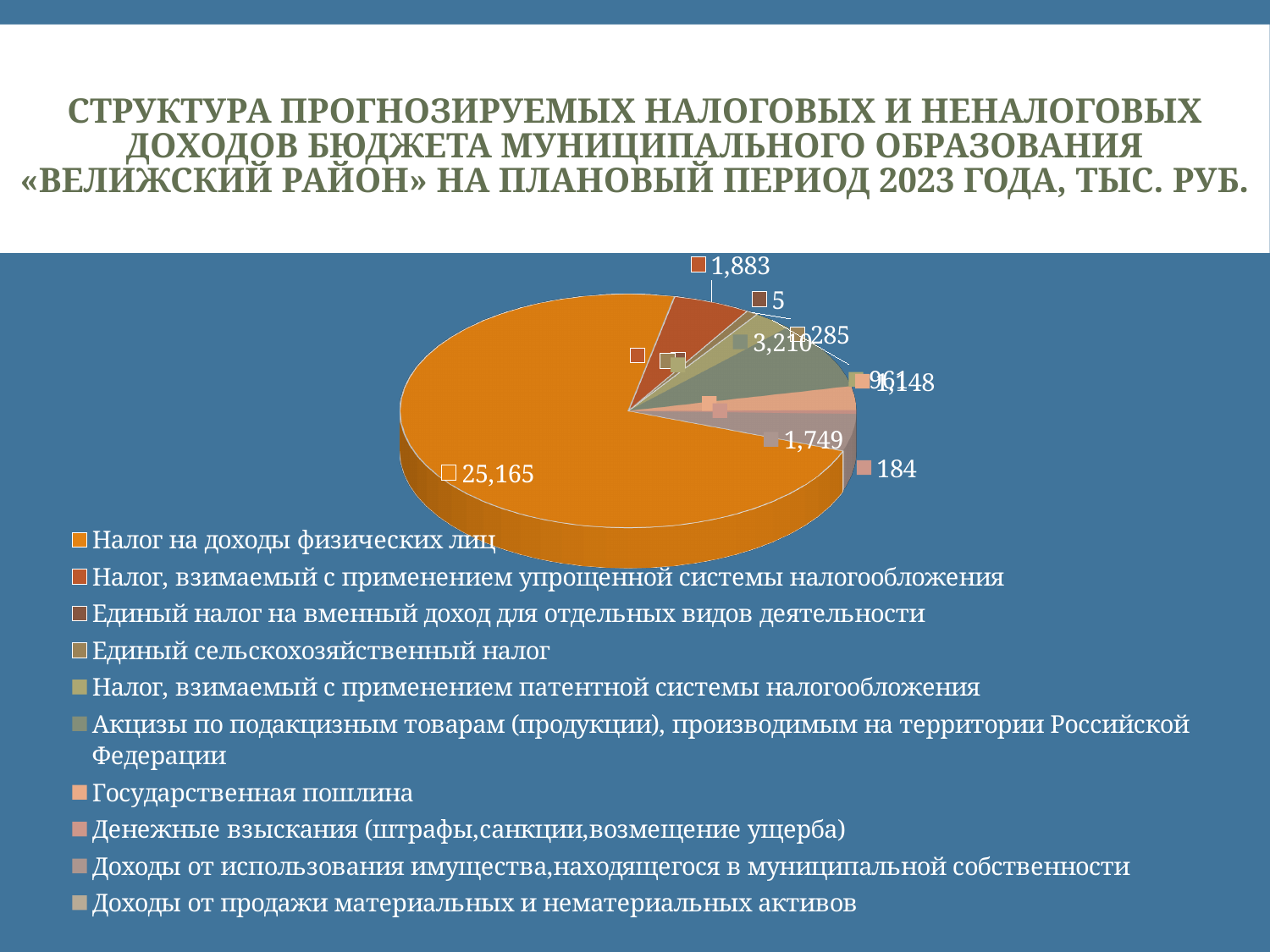
Which category has the largest slice of the pie? Налог на доходы физических лиц What is the value for Налог, взимаемый с применением упрощенной системы налогообложения? 1,883 What is the value for Налог на доходы физических лиц? 25,165 What is the difference between the value for Налог, взимаемый с применением упрощенной системы налогообложения (1,883) and the value for Единый налог на вменный доход для отдельных видов деятельности (5)? 1,878 What is the value for Единый налог на вменный доход для отдельных видов деятельности? 5 How many categories does the legend list? 10 What colour is the slice for Налог на доходы физических лиц? orange Which is larger: the value for Налог, взимаемый с применением упрощенной системы налогообложения or the value for Единый налог на вменный доход для отдельных видов деятельности? Налог, взимаемый с применением упрощенной системы налогообложения In what units are the values in the chart expressed, according to the slide title? тыс. руб. What kind of chart is shown on the slide? pie chart